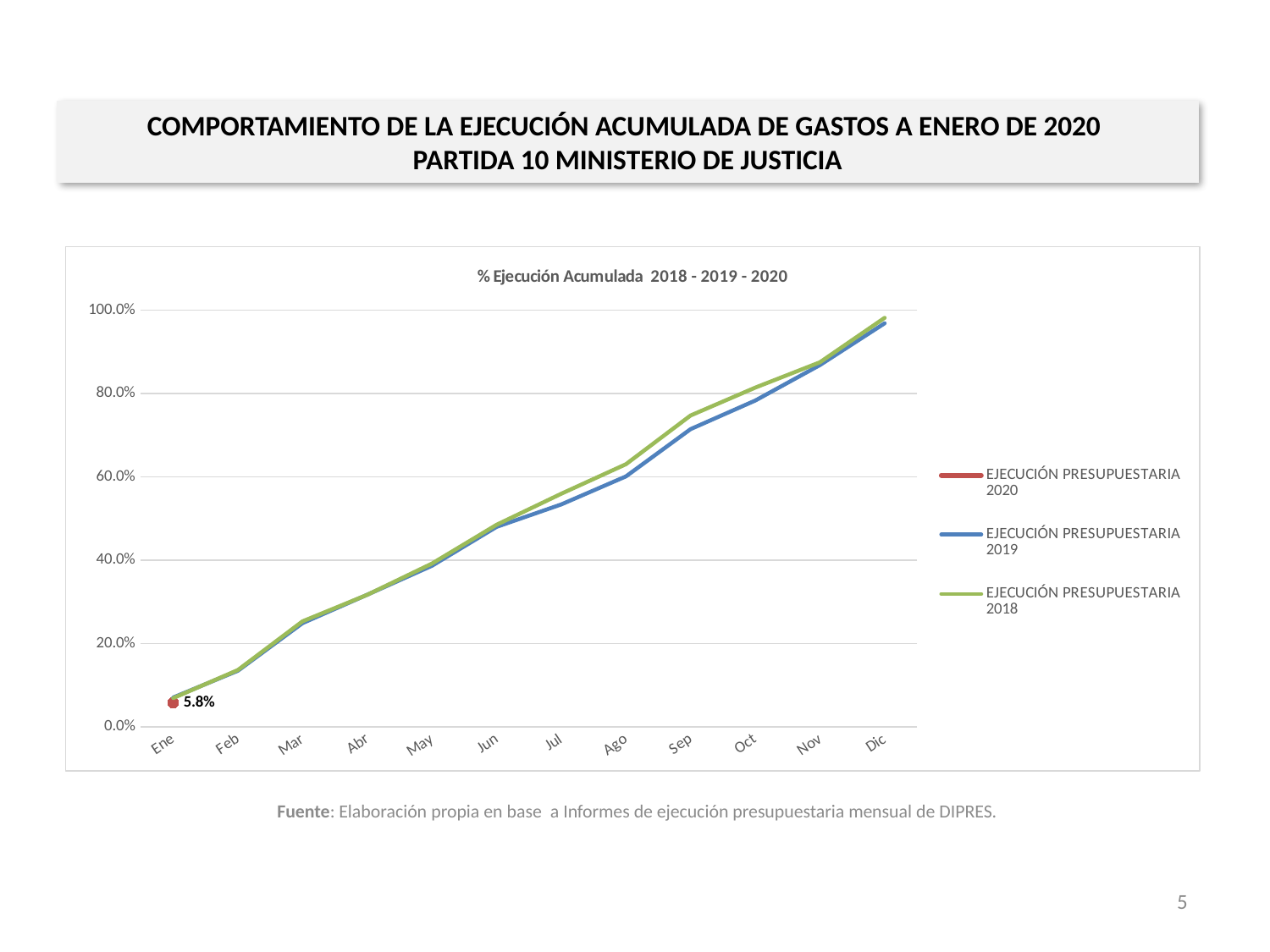
Is the value for EJECUCIÓN PRESUPUESTARIA 2018 in Sep greater or less than 60.0%? greater Do the values for EJECUCIÓN PRESUPUESTARIA 2019 rise or fall from Ene to Dic? Rise What kind of chart is shown on the slide? Line chart In which month does EJECUCIÓN PRESUPUESTARIA 2018 have its lowest value? Ene Is the value for EJECUCIÓN PRESUPUESTARIA 2018 in Mar greater or less than 40.0%? less How many series does the legend list? 3 What is the title of the chart? % Ejecución Acumulada 2018 - 2019 - 2020 Is the value for EJECUCIÓN PRESUPUESTARIA 2019 in Dic greater or less than 80.0%? greater What is the value shown for EJECUCIÓN PRESUPUESTARIA 2020 in Ene? 5.8% How many months are shown on the x axis? 12 In Oct, which series has the higher value: EJECUCIÓN PRESUPUESTARIA 2018 or EJECUCIÓN PRESUPUESTARIA 2019? EJECUCIÓN PRESUPUESTARIA 2018 In which month does EJECUCIÓN PRESUPUESTARIA 2019 reach its highest value? Dic